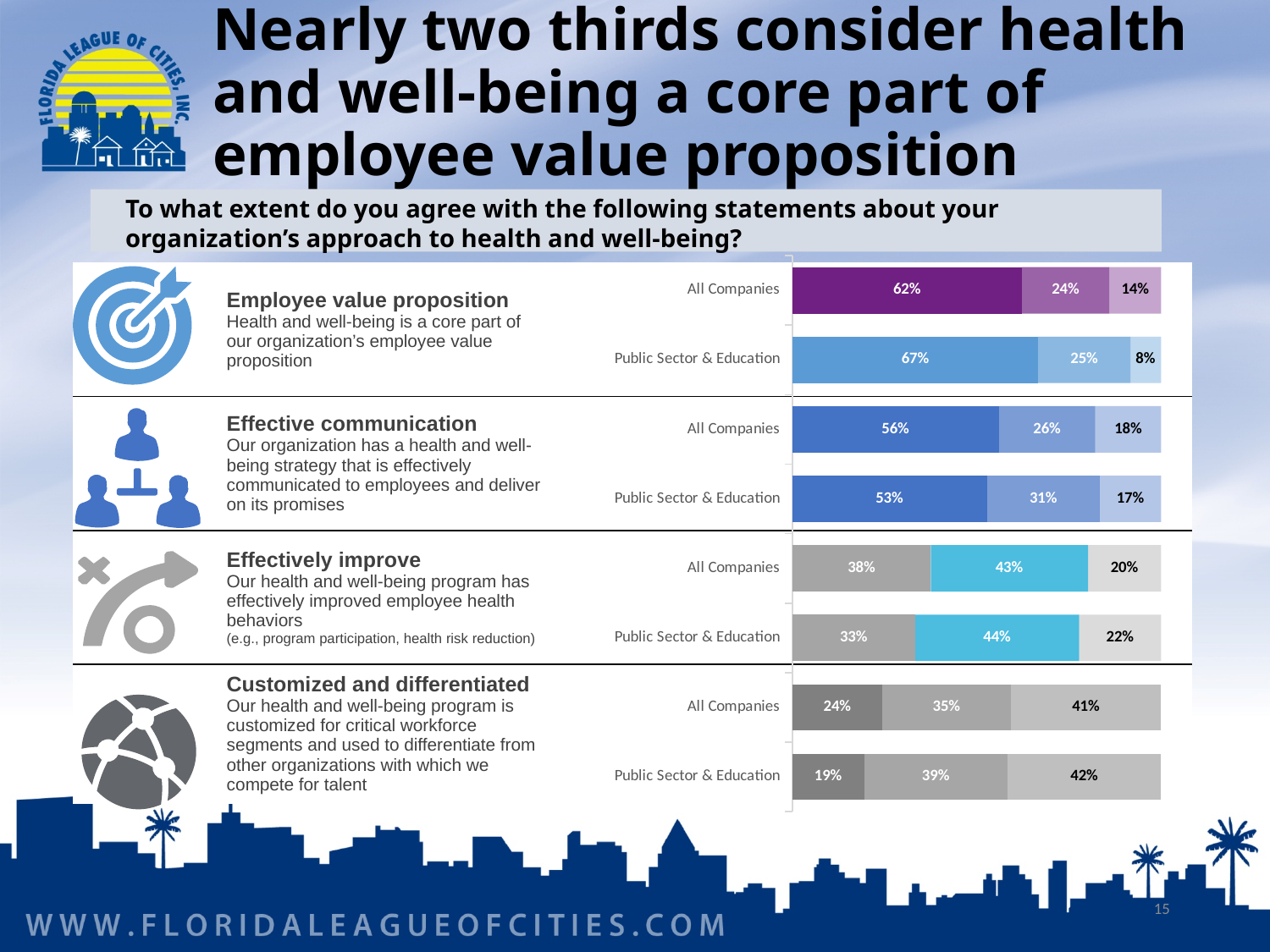
In the Employee value proposition chart, what is the value of the leftmost segment of the Public Sector & Education bar? 67% In the Customized and differentiated chart, what is the value of the rightmost segment of the All Companies bar? 41% In the Effective communication chart, which bar has the larger leftmost segment, All Companies or Public Sector & Education? All Companies In the Employee value proposition chart, how many percentage points larger is the leftmost segment for Public Sector & Education than for All Companies? 5 percentage points What kind of chart is used to show the survey results on the slide? Stacked bar chart Across the four statement charts, which statement has the smallest leftmost segment for All Companies? Customized and differentiated In the Effectively improve chart, what is the value of the middle segment of the Public Sector & Education bar? 44% Across the four statement charts, which statement has the largest leftmost segment for Public Sector & Education? Employee value proposition What are the two row labels shown for each statement chart? All Companies and Public Sector & Education In the Employee value proposition chart, what is the total of the three segments of the All Companies bar? 100% How many statements are charted on the slide? 4 In the Employee value proposition chart, what is the value of the leftmost segment of the All Companies bar? 62%